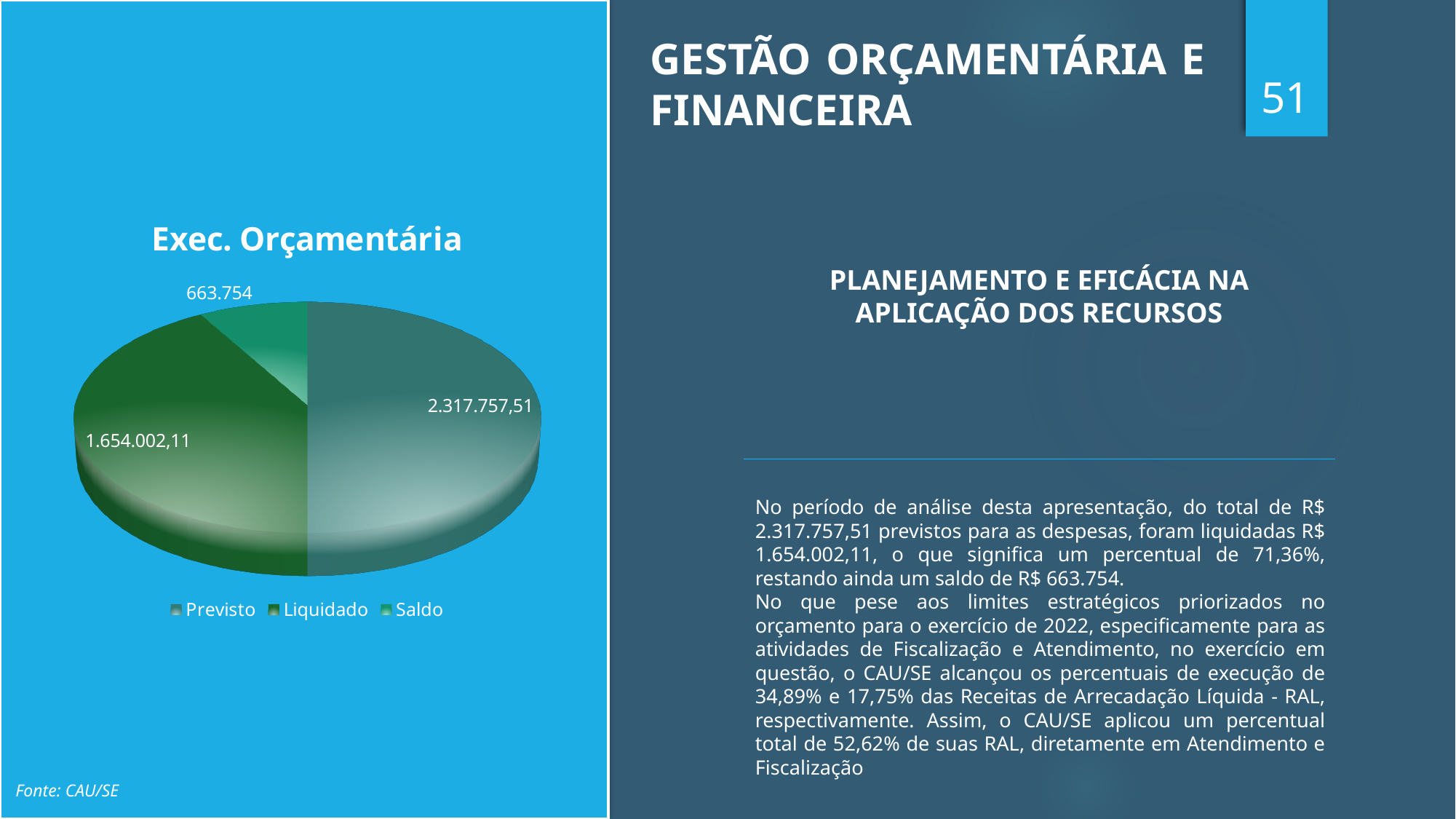
What is the title of the chart on the slide? Exec. Orçamentária What is the value of the Liquidado slice in the Exec. Orçamentária pie chart? 1.654.002,11 What is the value of the Previsto slice in the Exec. Orçamentária pie chart? 2.317.757,51 Which slice of the Exec. Orçamentária pie chart has the largest value? Previsto What is the value of the Saldo slice in the Exec. Orçamentária pie chart? 663.754 Which slice of the Exec. Orçamentária pie chart has the smallest value? Saldo How many slices does the Exec. Orçamentária pie chart have? 3 In the Exec. Orçamentária chart, which is larger: Liquidado or Saldo? Liquidado How many entries does the legend of the Exec. Orçamentária chart list? 3 What share of the Exec. Orçamentária pie does the Previsto slice represent? 50% What type of chart is shown on the slide? Pie chart What is the difference between the Liquidado and Saldo values in the Exec. Orçamentária chart? 990.248,11